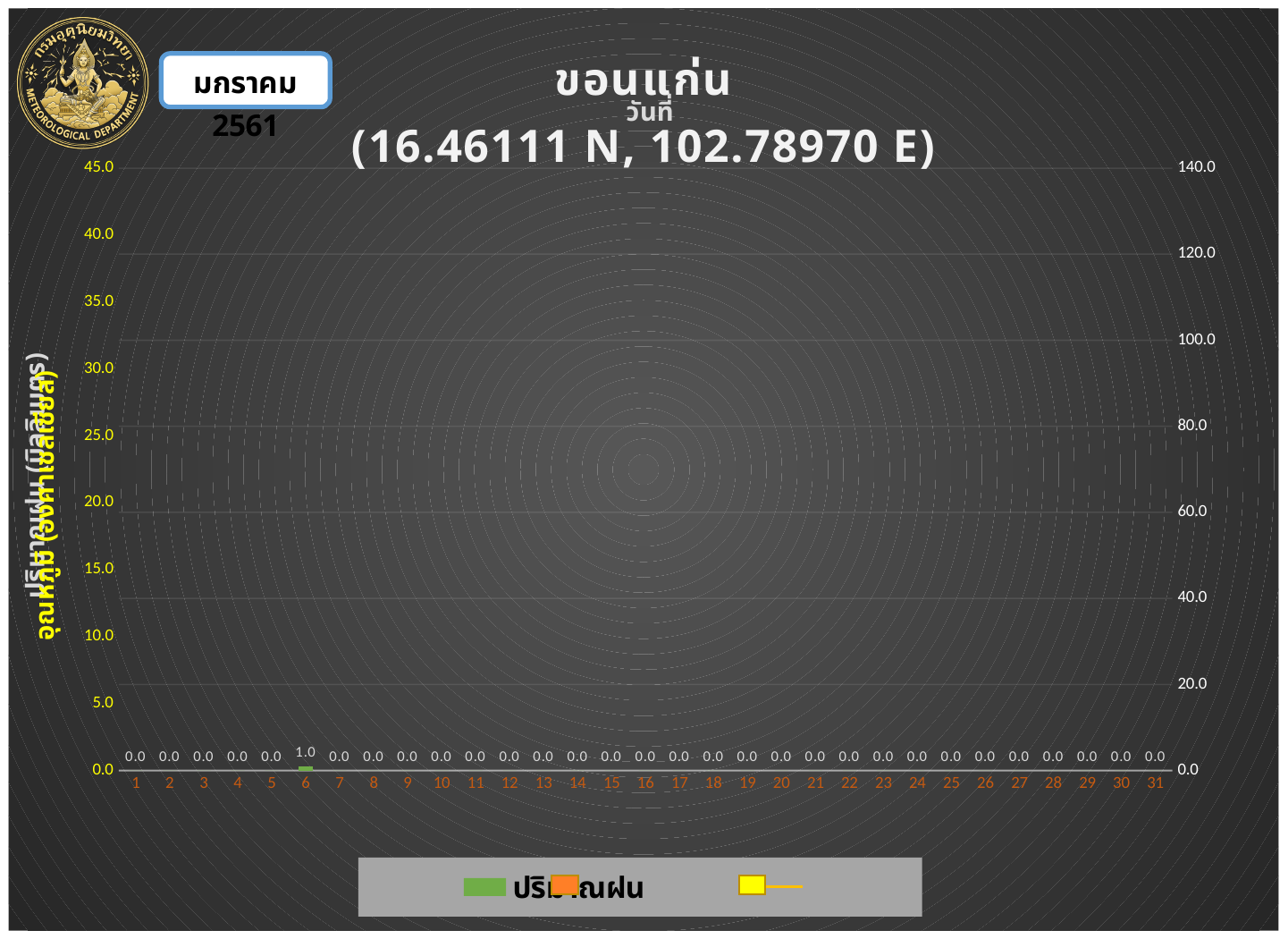
What is the value shown for day 6 on the chart? 1.0 Is the value for day 6 greater or less than 5.0? less How many days are shown along the x axis of the chart? 31 What is the highest tick value shown on the left vertical axis? 45.0 Which day has the highest value on the chart? 6 How many days on the chart have a value other than 0.0? 1 Which has the larger value, day 6 or day 15? day 6 What is the value shown for day 1 on the chart? 0.0 What station name is given in the chart title? ขอนแก่น What is the value shown for day 31 on the chart? 0.0 What is the difference between the value for day 6 and the value for day 1? 1.0 What kind of chart is shown on the slide? bar chart